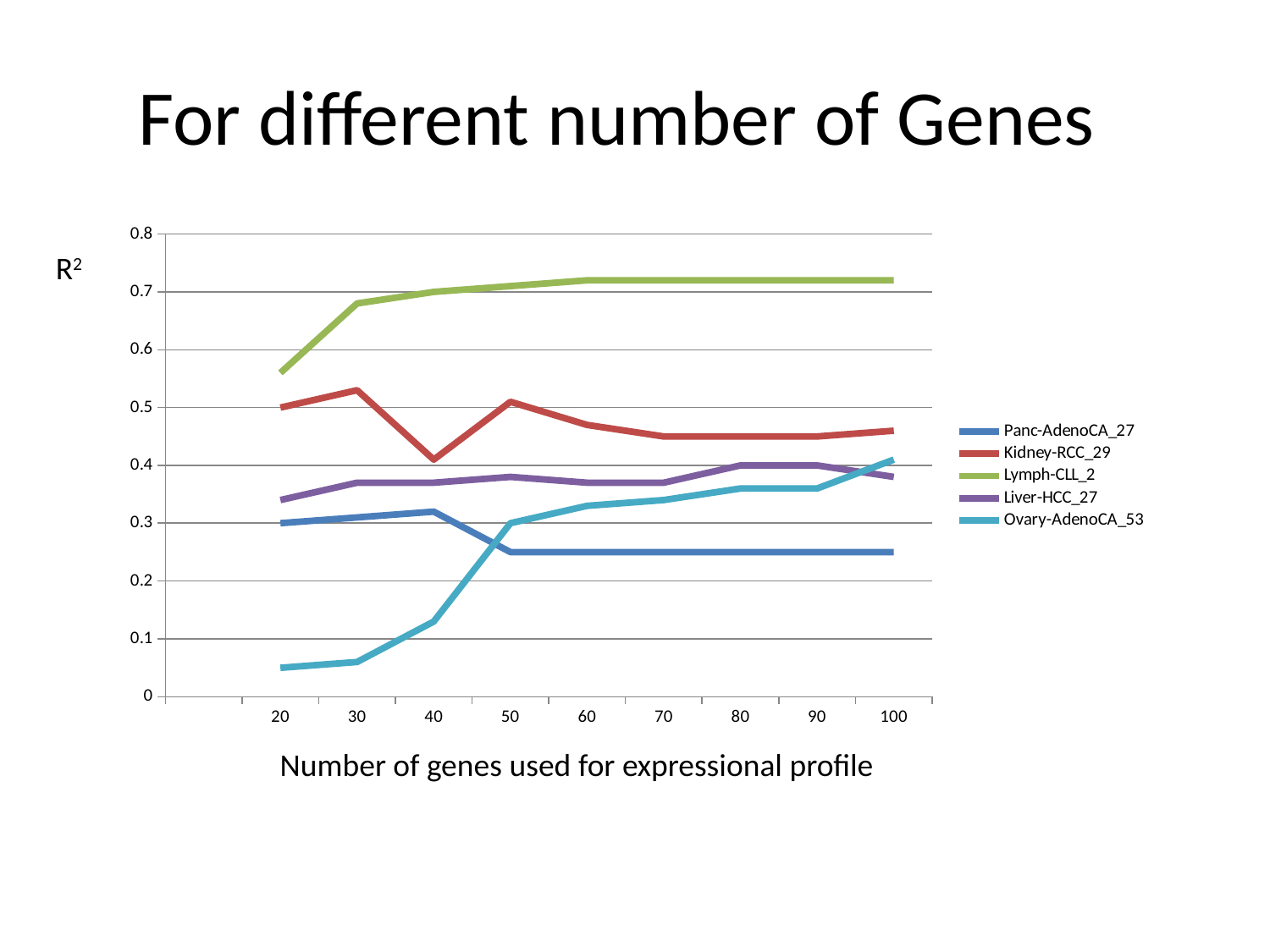
Which series has the lowest R² at 20 genes? Ovary-AdenoCA_53 Which series has the highest R² at 100 genes? Lymph-CLL_2 Is the R² for Ovary-AdenoCA_53 at 20 genes greater or less than 0.1? less At 60 genes, which series has the higher R²: Kidney-RCC_29 or Liver-HCC_27? Kidney-RCC_29 Is the R² for Panc-AdenoCA_27 at 100 genes greater or less than 0.3? less Does the R² for Ovary-AdenoCA_53 generally rise or fall as the number of genes increases? rise How many series does the legend list? 5 How many values are shown on the x axis (number of genes)? 9 Which series has the lowest R² at 100 genes? Panc-AdenoCA_27 Is the R² for Lymph-CLL_2 at 100 genes greater or less than 0.7? greater What kind of chart is shown on the slide? line chart What is the label of the x axis? Number of genes used for expressional profile